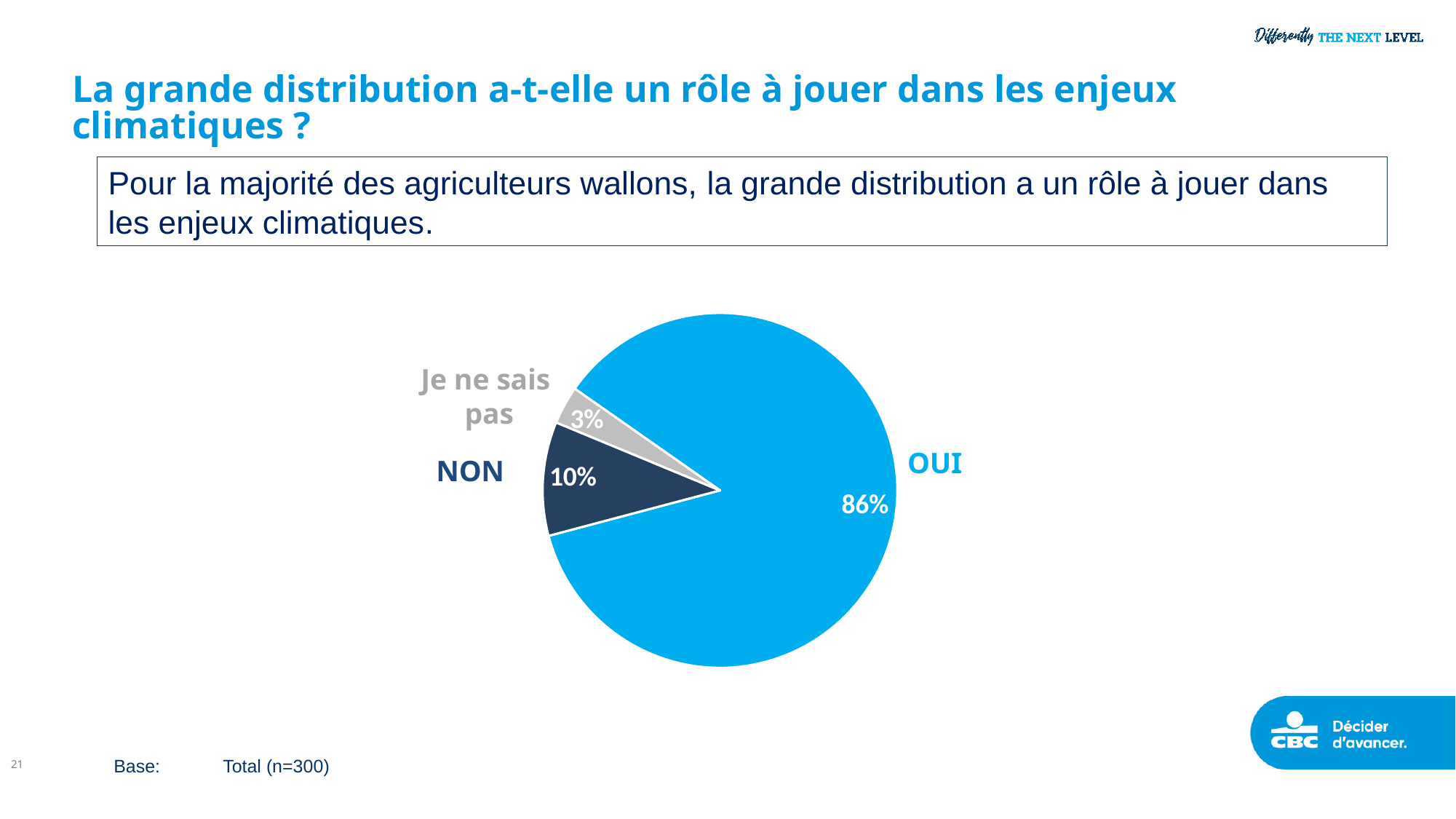
What colour is the OUI slice of the pie? light blue What kind of chart is shown on the slide? pie chart What percentage of respondents answered NON? 10% What is the difference in percentage points between NON and 'Je ne sais pas'? 7 Which response has the largest share of the pie? OUI What is the base (sample size) stated for the chart? Total (n=300) What percentage of respondents answered OUI? 86% Which is larger, the share for NON or the share for 'Je ne sais pas'? NON Which response has the smallest share of the pie? Je ne sais pas How many slices does the pie chart have? 3 What percentage of respondents answered 'Je ne sais pas'? 3% What is the difference in percentage points between OUI and NON? 76